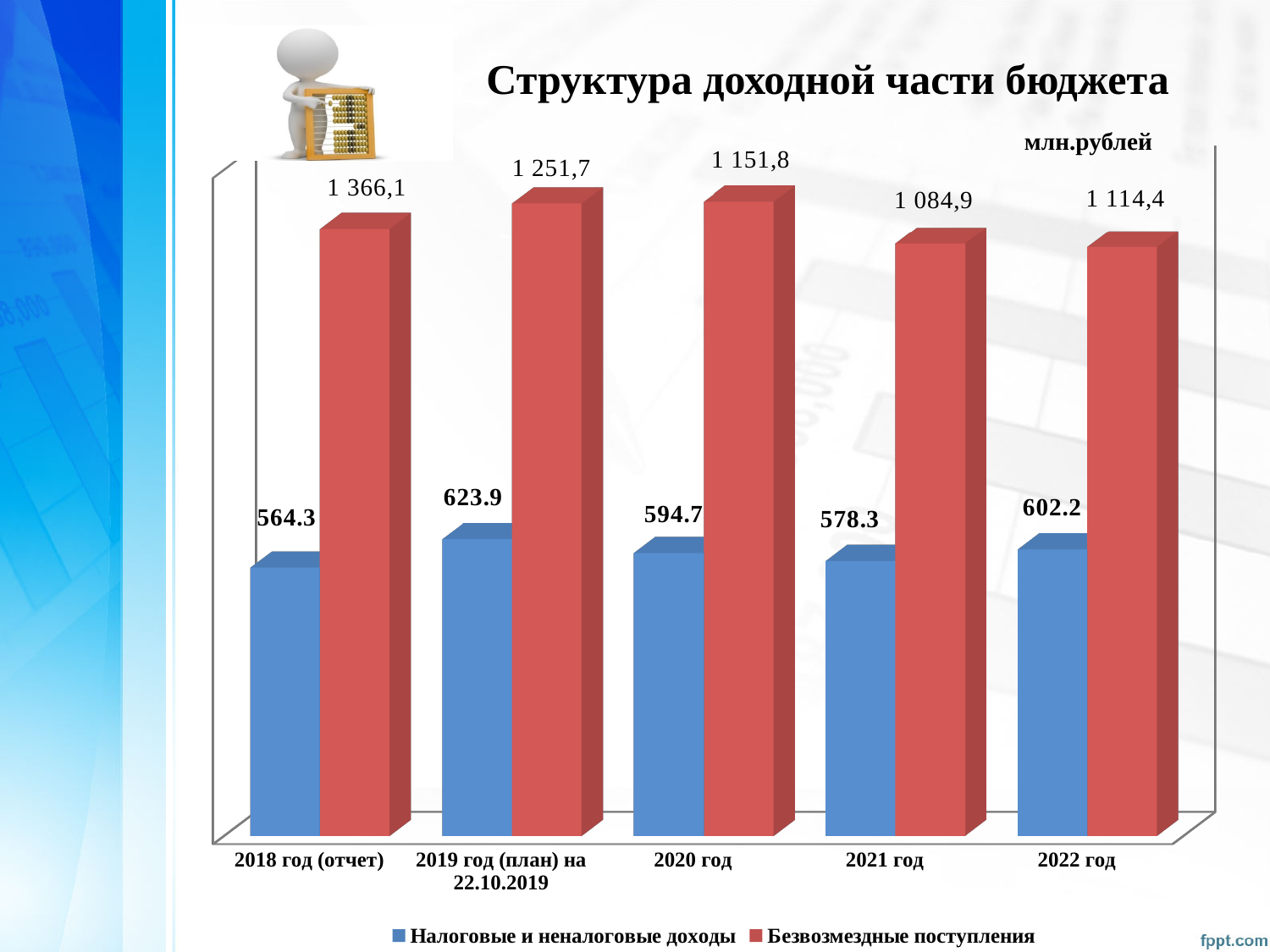
What is the value of Безвозмездные поступления for 2022 год? 1 114,4 What type of chart is shown on the slide? Bar chart In which year is Налоговые и неналоговые доходы highest? 2019 год (план) на 22.10.2019 How many year categories are shown on the x axis? 5 By how much does Безвозмездные поступления in 2018 exceed the value in 2019? 114,4 What is the value of Безвозмездные поступления for 2020 год? 1 151,8 What is the difference between Налоговые и неналоговые доходы in 2019 and in 2018? 59.6 What is the value of Налоговые и неналоговые доходы for 2018 год (отчет)? 564.3 How many series does the legend list? 2 Which is larger in 2021 год: Налоговые и неналоговые доходы or Безвозмездные поступления? Безвозмездные поступления